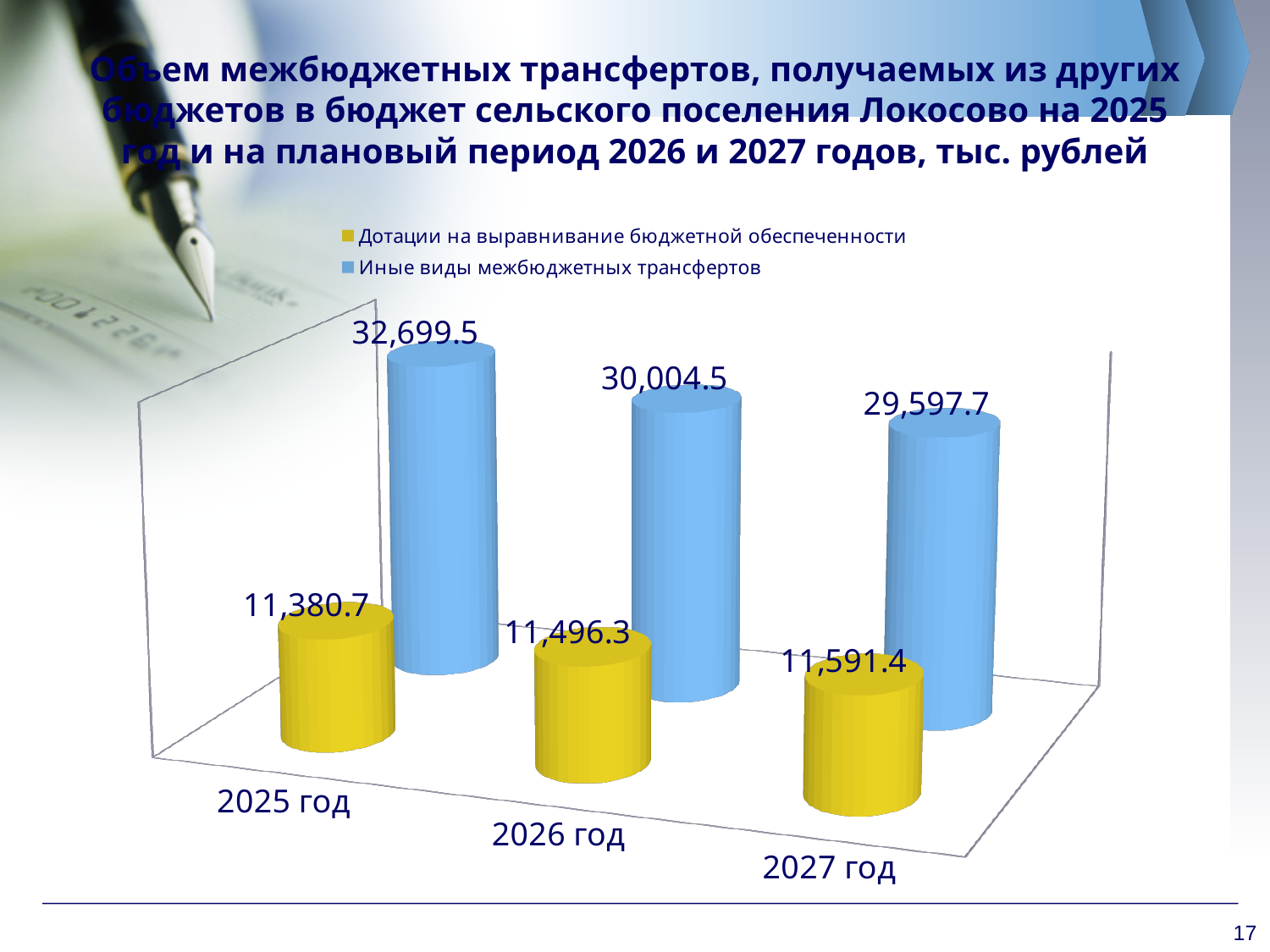
What is the difference between Дотации на выравнивание бюджетной обеспеченности in 2027 год and 2025 год? 210.7 What is the value of Иные виды межбюджетных трансфертов for 2027 год? 29,597.7 In which year is Дотации на выравнивание бюджетной обеспеченности lowest? 2025 год What is the value of Иные виды межбюджетных трансфертов for 2025 год? 32,699.5 What is the difference between Иные виды межбюджетных трансфертов in 2025 год and 2026 год? 2,695.0 What is the value of Дотации на выравнивание бюджетной обеспеченности for 2027 год? 11,591.4 How many series does the legend list? 2 In which year is Иные виды межбюджетных трансфертов highest? 2025 год Does Иные виды межбюджетных трансфертов rise or fall from 2025 год to 2027 год? fall How many years are shown on the x axis? 3 Which is larger in 2026 год: Дотации на выравнивание бюджетной обеспеченности or Иные виды межбюджетных трансфертов? Иные виды межбюджетных трансфертов What is the value of Дотации на выравнивание бюджетной обеспеченности for 2026 год? 11,496.3